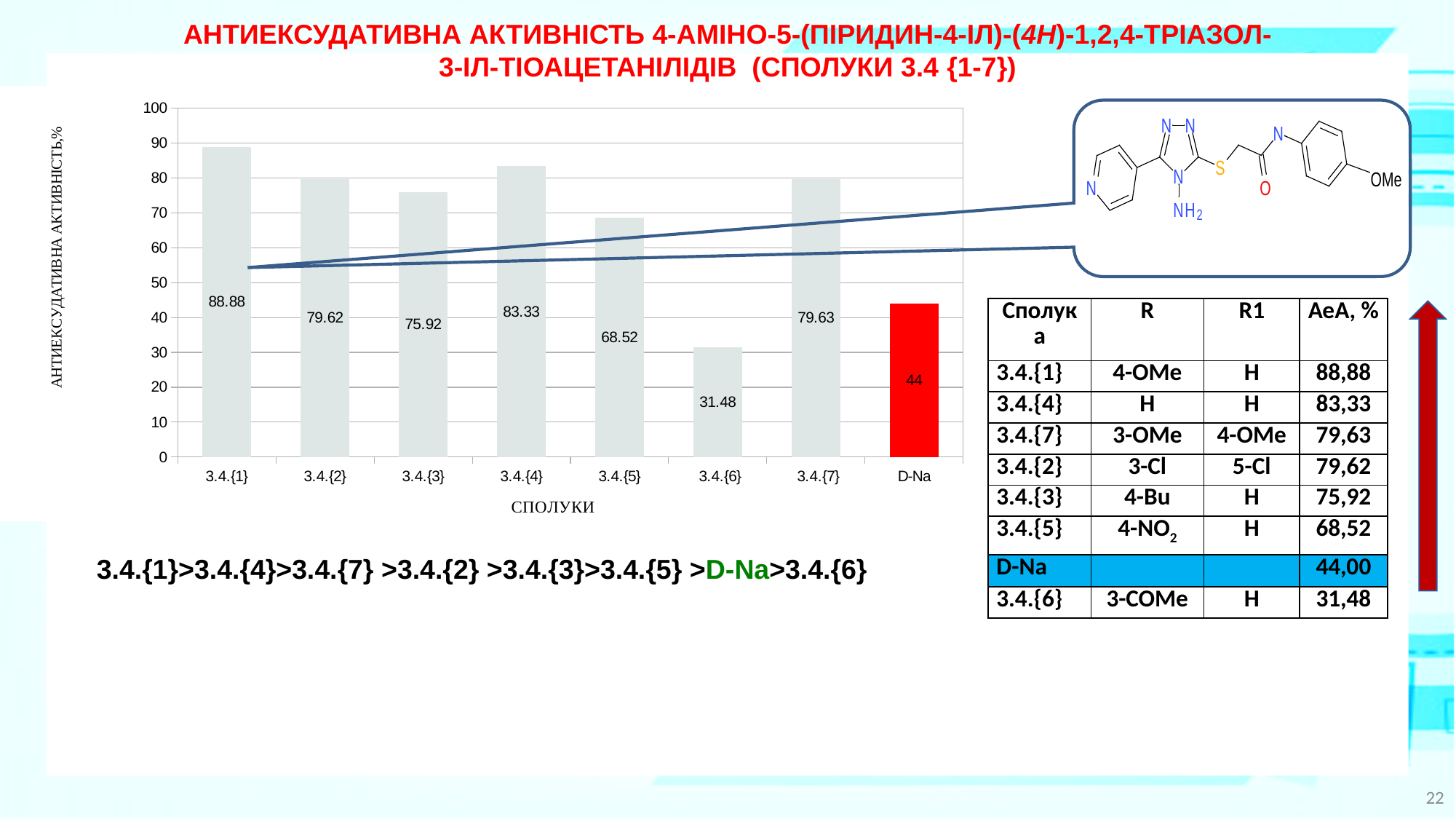
Which is larger, the value for 3.4.{4} or the value for 3.4.{5}? 3.4.{4} What is the difference between the values for 3.4.{1} and 3.4.{4}? 5.55 Which category has the lowest value? 3.4.{6} Which category has the highest value? 3.4.{1} How many categories are shown on the x axis? 8 What kind of chart is shown on the slide? bar chart What is the title of the x axis of the chart? СПОЛУКИ What is the value for 3.4.{6}? 31.48 What is the value for 3.4.{1}? 88.88 Is the value for 3.4.{3} greater or less than 70? greater What is the value for D-Na? 44 What is the difference between the values for D-Na and 3.4.{6}? 12.52